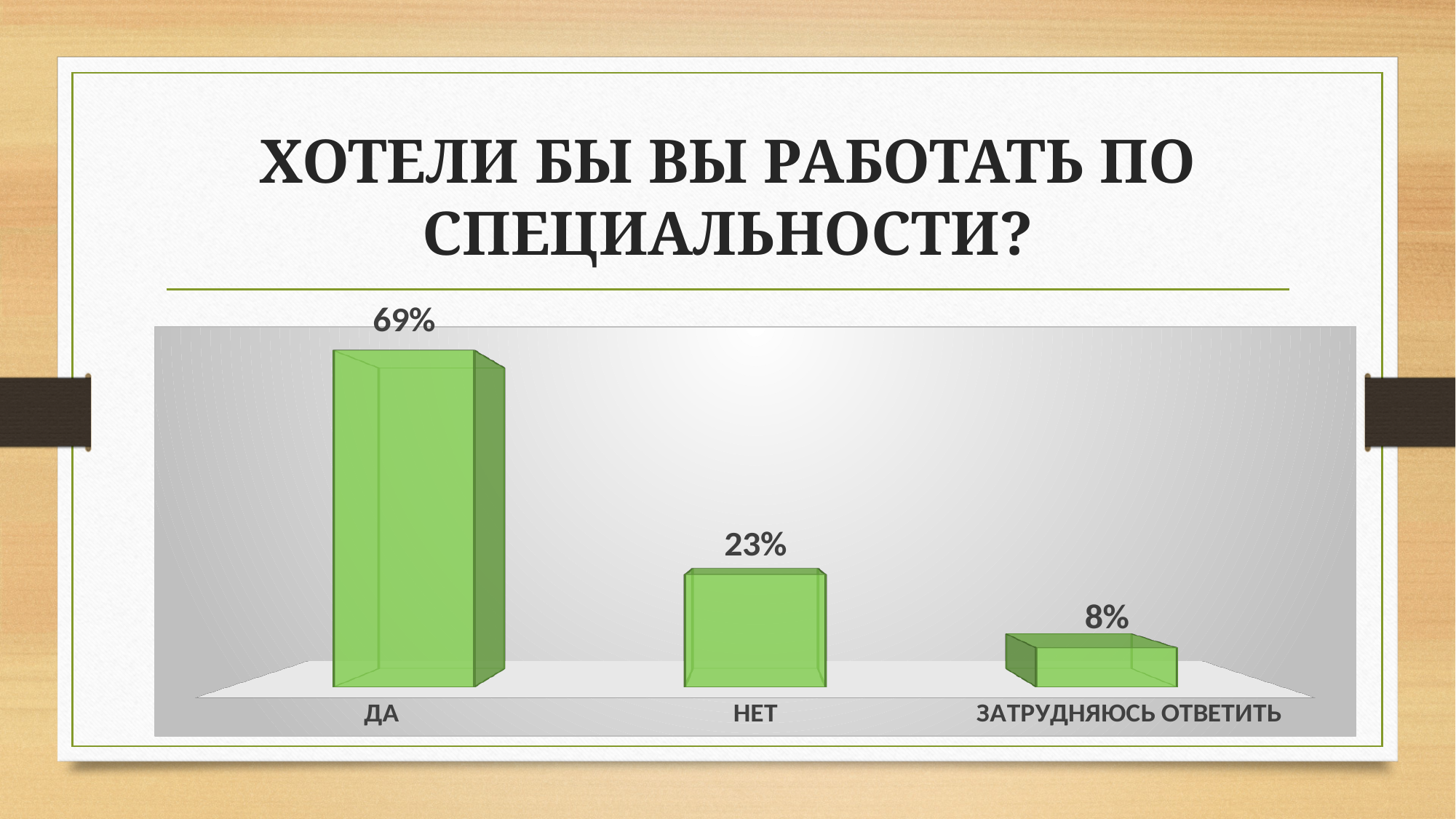
Which category has the highest value? ДА Which is larger, the value for НЕТ or the value for ЗАТРУДНЯЮСЬ ОТВЕТИТЬ? НЕТ What kind of chart is shown on the slide? bar chart What is the title of the slide above the chart? ХОТЕЛИ БЫ ВЫ РАБОТАТЬ ПО СПЕЦИАЛЬНОСТИ? What is the value for ДА? 69% What is the value for НЕТ? 23% What is the value for ЗАТРУДНЯЮСЬ ОТВЕТИТЬ? 8% Which category has the lowest value? ЗАТРУДНЯЮСЬ ОТВЕТИТЬ What is the difference between the values for ДА and НЕТ? 46% Do the values rise or fall from left to right across the categories? fall What is the difference between the values for НЕТ and ЗАТРУДНЯЮСЬ ОТВЕТИТЬ? 15% How many categories are shown in the chart? 3